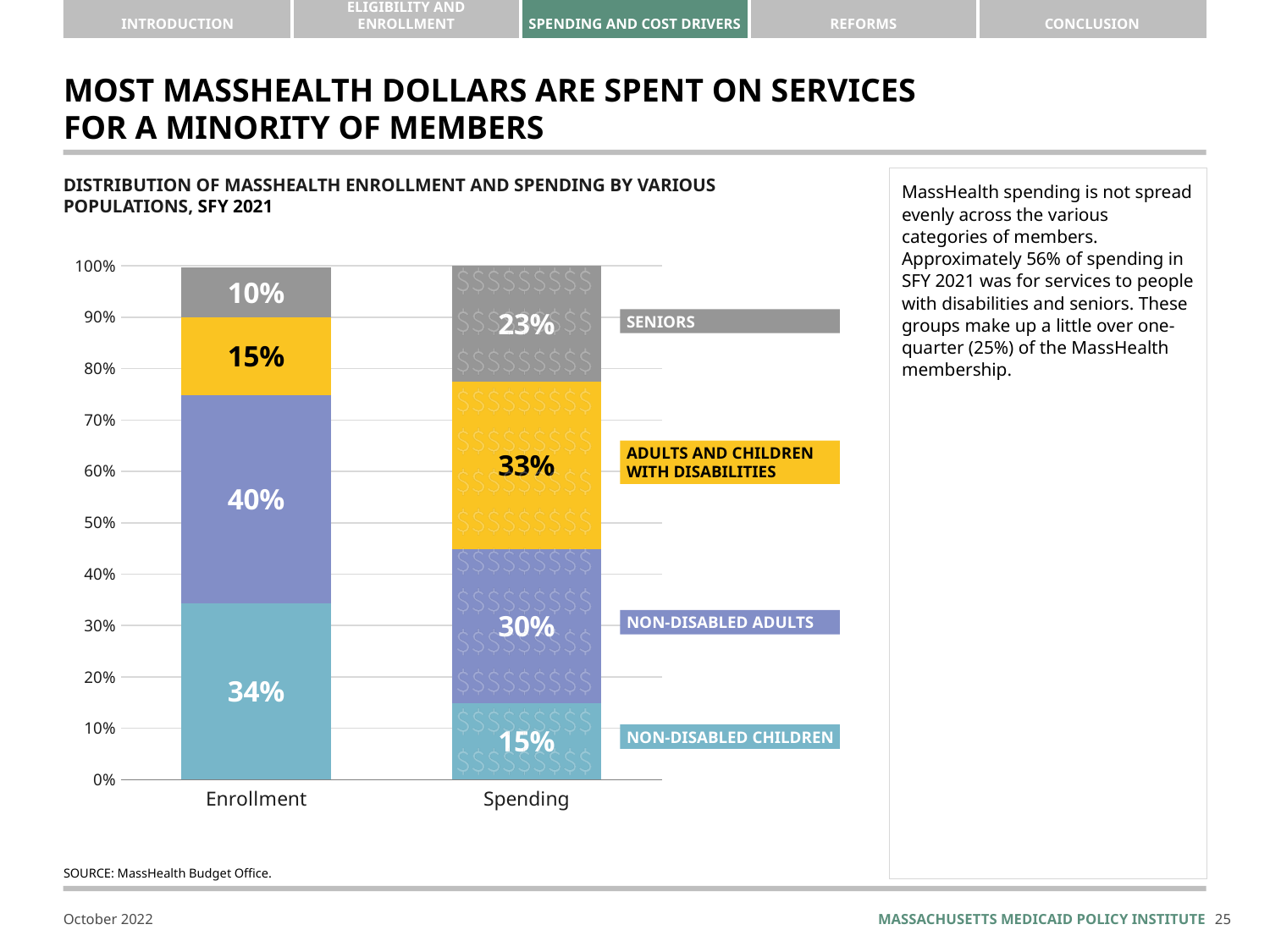
What is the difference between the seniors' share of spending and their share of enrollment? 13 percentage points What share of MassHealth enrollment is made up of non-disabled adults? 40% What is the combined share of spending for seniors and adults and children with disabilities? 56% What share of MassHealth spending goes to seniors? 23% What share of spending is for adults and children with disabilities? 33% How many population groups does the legend list? 4 How many bars (categories) are shown on the x axis? 2 What share of enrollment is made up of non-disabled children? 34% Which population group accounts for the largest share of spending? Adults and children with disabilities Which population group accounts for the smallest share of enrollment? Seniors What type of chart is shown on the slide? Stacked bar chart Is the non-disabled children's share larger in the Enrollment bar or the Spending bar? Enrollment